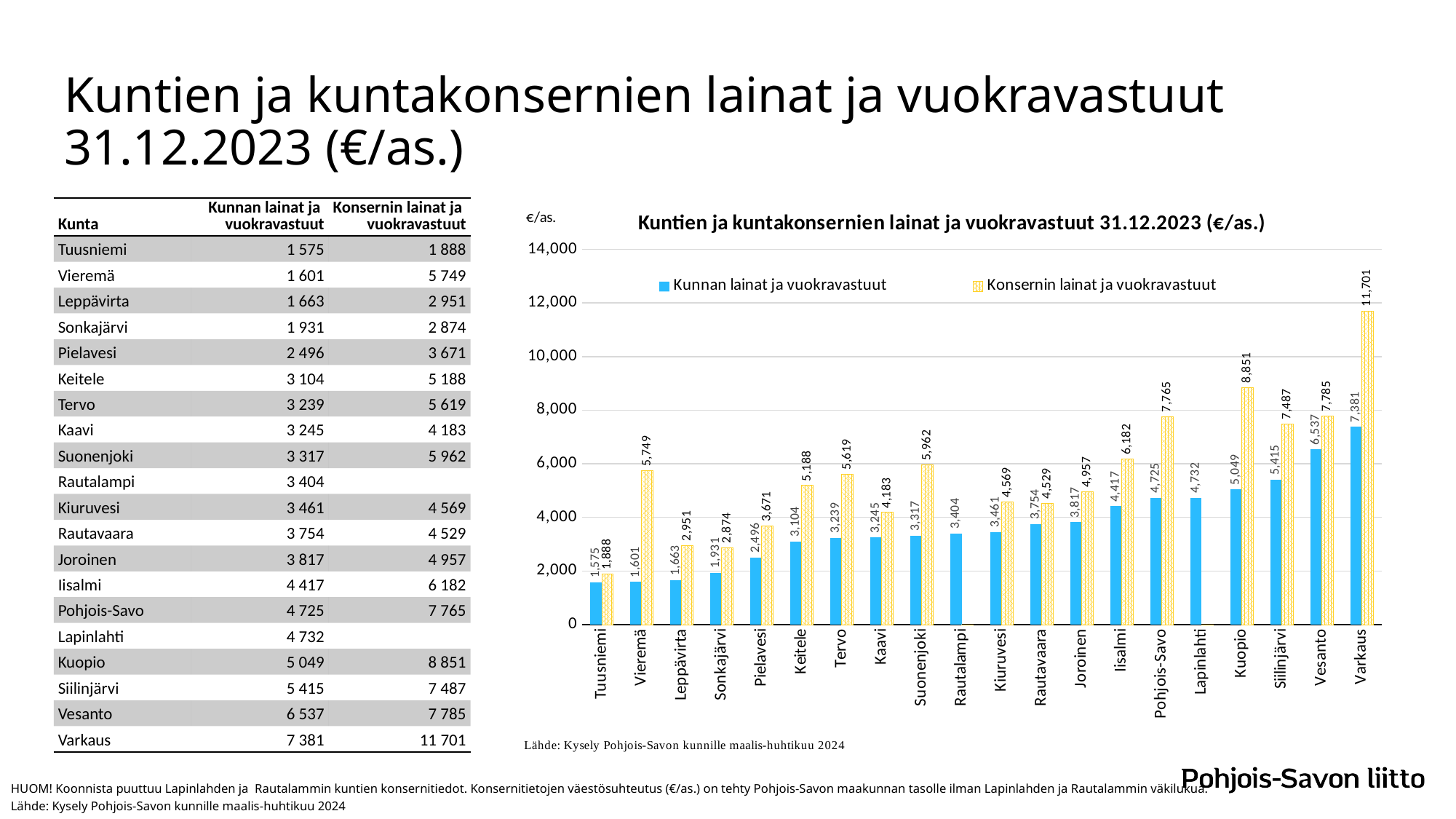
How many municipalities are shown on the x axis of the chart? 20 Do the Kunnan lainat ja vuokravastuut values rise or fall from left to right along the x axis? Rise Which municipality has the highest Konsernin lainat ja vuokravastuut value? Varkaus What kind of chart is shown on the slide? Bar chart Which is larger: the Konsernin lainat ja vuokravastuut value for Siilinjärvi or for Vesanto? Vesanto What is the value of Kunnan lainat ja vuokravastuut for Tuusniemi? 1,575 What is the difference between the Konsernin and Kunnan lainat ja vuokravastuut values for Vieremä? 4,148 What is the value of Konsernin lainat ja vuokravastuut for Kuopio? 8,851 Is the Konsernin lainat ja vuokravastuut value for Varkaus greater or less than 10,000? greater How many series does the chart legend list? 2 Which municipality has the lowest Kunnan lainat ja vuokravastuut value? Tuusniemi What is the value of Kunnan lainat ja vuokravastuut for Varkaus? 7,381